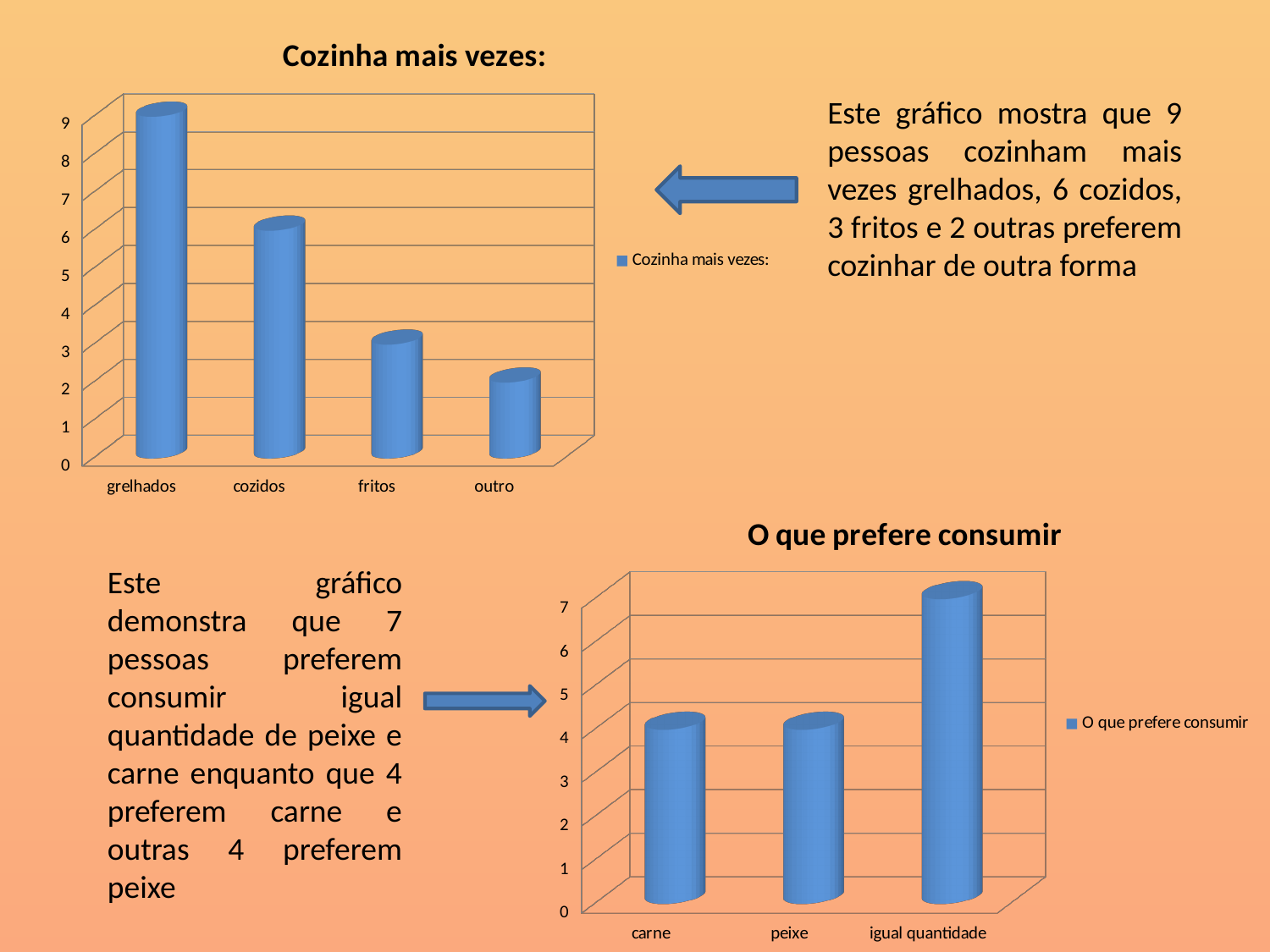
In the chart titled "Cozinha mais vezes:", which category has the highest value? grelhados In the chart titled "Cozinha mais vezes:", what is the value for grelhados? 9 In the chart titled "O que prefere consumir", what is the value for carne? 4 In the chart titled "Cozinha mais vezes:", how many categories are shown on the x axis? 4 In the chart titled "Cozinha mais vezes:", which category has the lowest value? outro In the chart titled "Cozinha mais vezes:", what is the difference between the values for grelhados and fritos? 6 In the chart titled "O que prefere consumir", which category has the highest value? igual quantidade In the chart titled "Cozinha mais vezes:", what is the value for cozidos? 6 In the chart titled "O que prefere consumir", what is the value for igual quantidade? 7 In the chart titled "O que prefere consumir", what is the difference between the values for igual quantidade and peixe? 3 What kind of chart is the chart titled "O que prefere consumir"? bar chart In the chart titled "Cozinha mais vezes:", do the values rise or fall from left to right along the x axis? fall